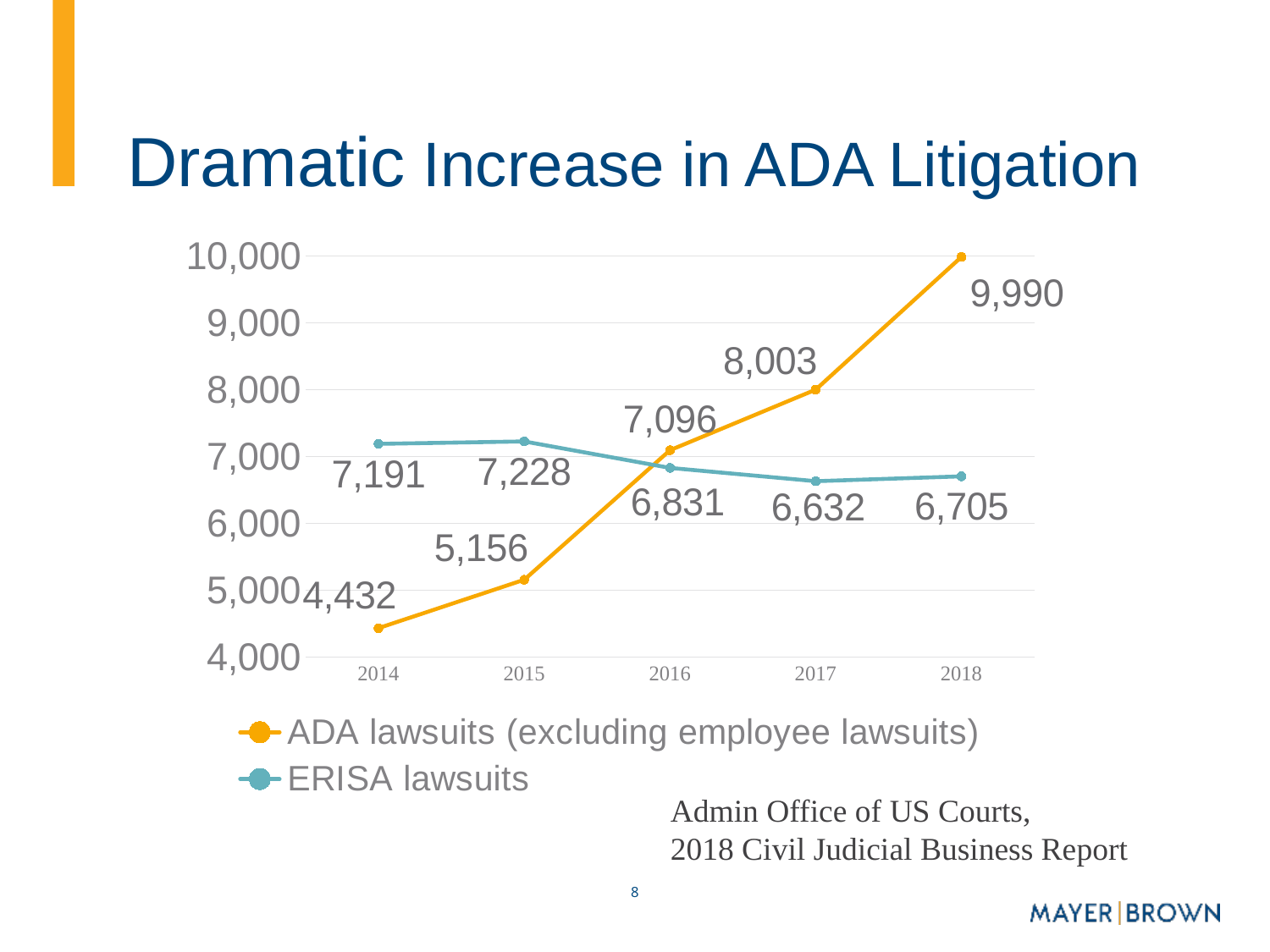
In which year is the ADA lawsuits (excluding employee lawsuits) value highest? 2018 Is the value for ADA lawsuits in 2017 greater or less than 9,000? less What is the value for ADA lawsuits (excluding employee lawsuits) in 2014? 4,432 Which is larger in 2016: ADA lawsuits (excluding employee lawsuits) or ERISA lawsuits? ADA lawsuits (excluding employee lawsuits) How many series does the legend list? 2 What kind of chart is shown on the slide? line chart In which year is the ERISA lawsuits value lowest? 2017 What is the value for ERISA lawsuits in 2015? 7,228 What is the difference between ADA lawsuits in 2018 and ADA lawsuits in 2014? 5,558 Do the ADA lawsuits (excluding employee lawsuits) values rise or fall from 2014 to 2018? rise How many years are shown on the x axis? 5 What is the value for ADA lawsuits (excluding employee lawsuits) in 2018? 9,990